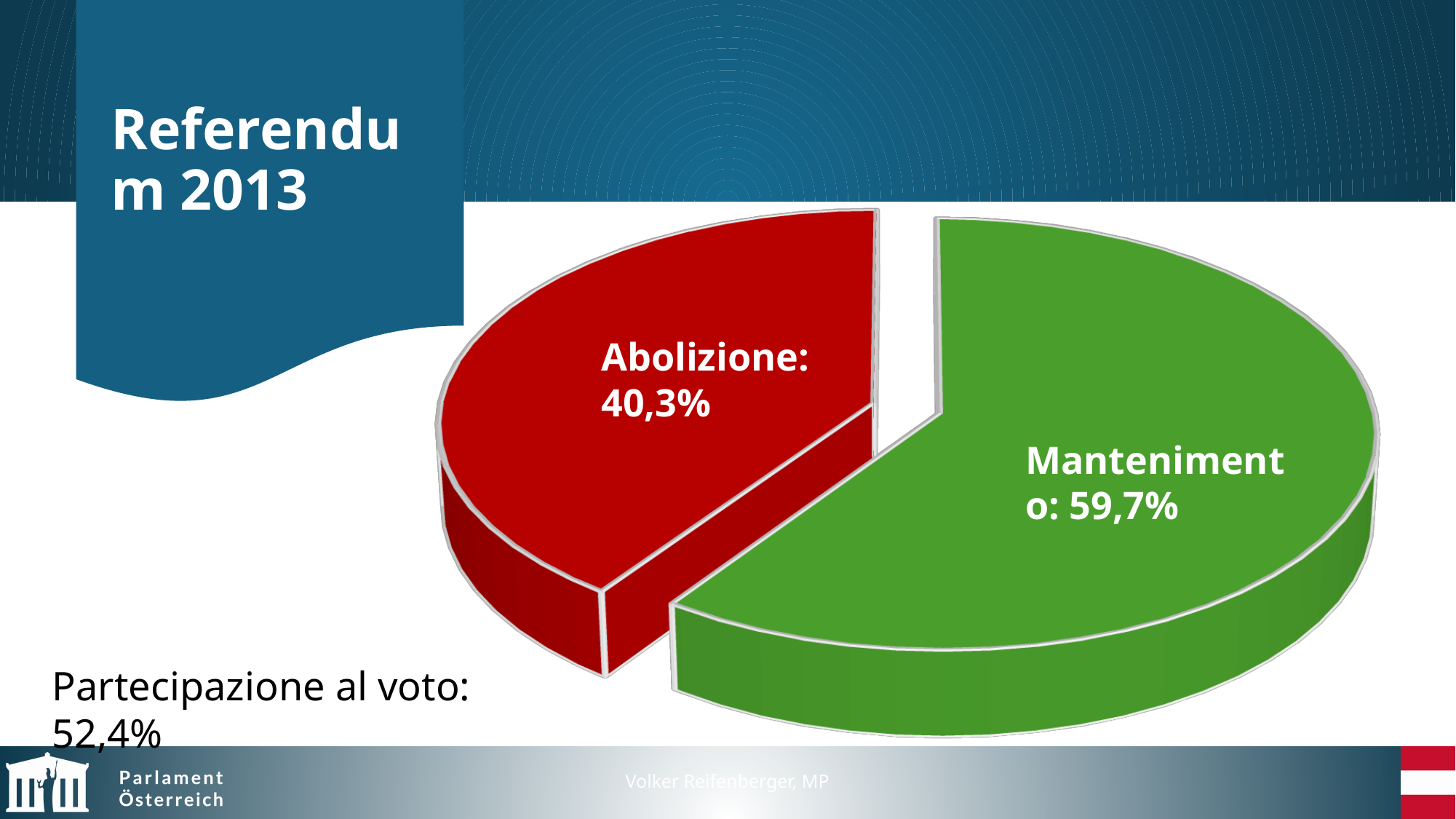
What is the difference in percentage points between Mantenimento and Abolizione? 19,4 What kind of chart is shown on the slide? pie chart Is the value for Mantenimento greater or less than 50%? greater What colour is the Abolizione slice? red What share of the pie does Abolizione have? 40,3% What colour is the Mantenimento slice? green What share of the pie does Mantenimento have? 59,7% Which is larger, Abolizione or Mantenimento? Mantenimento How many slices does the pie chart have? 2 Which slice is the smallest? Abolizione Which slice is the largest? Mantenimento